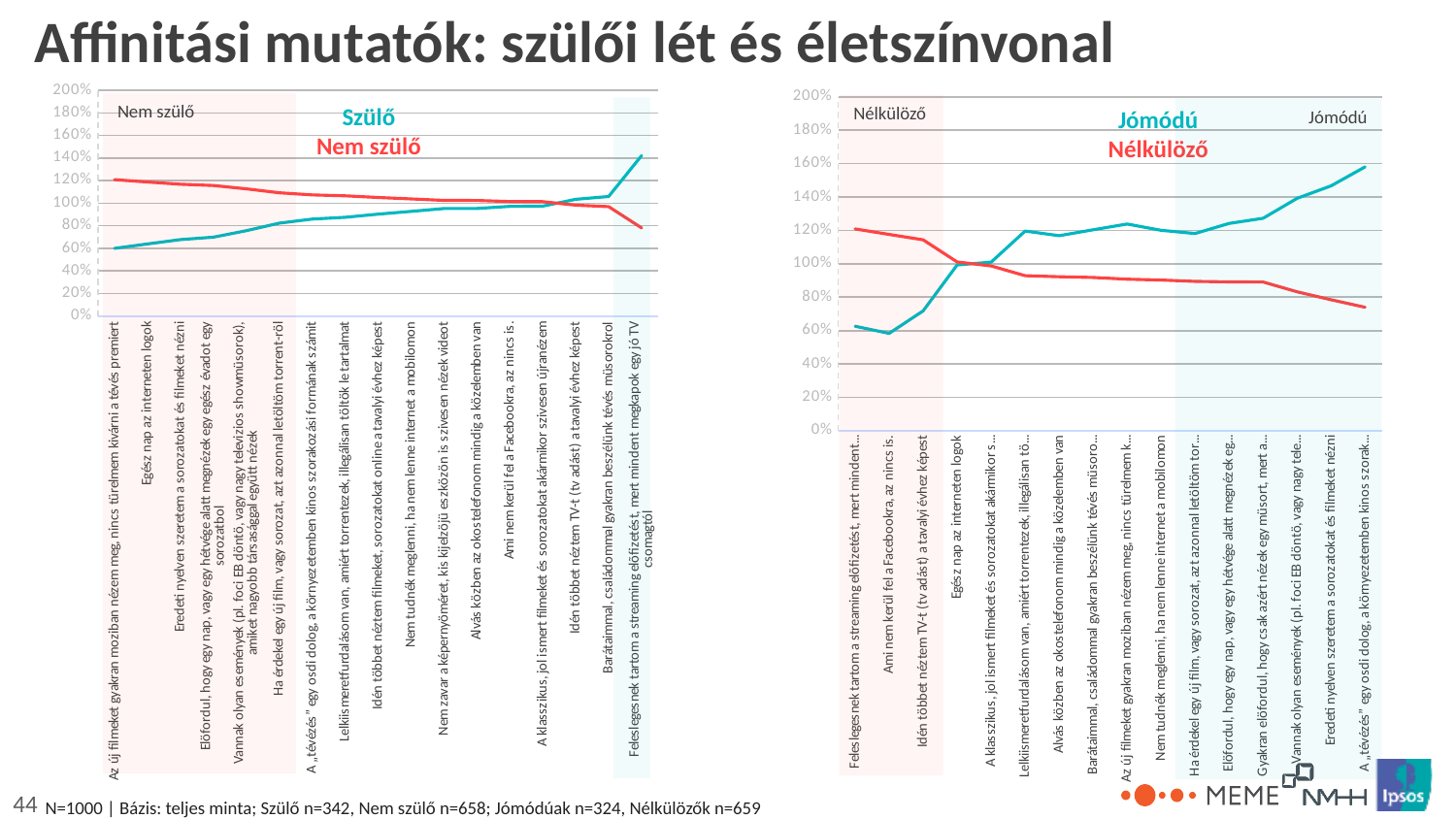
On the left chart, is the Szülő value for 'Feleslegesnek tartom a streaming előfizetést, mert mindent megkapok egy jó TV csomagtól' greater or less than 120%? greater On the right chart, is the Nélkülöző value for 'Feleslegesnek tartom a streaming előfizetést, mert mindent...' greater or less than 100%? greater On the left chart, is the Nem szülő value for 'Az új filmeket gyakran moziban nézem meg, nincs türelmem kivárni a tévés premiert' greater or less than 100%? greater On the right chart, for 'A „tévézés" egy osdi dolog, a környezetemben kinos szorak...', which series has the larger value: Jómódú or Nélkülöző? Jómódú On the left chart, does the Szülő line generally rise or fall from left to right along the x axis? Rise On the left chart, for 'Egész nap az interneten logok', which series has the larger value: Szülő or Nem szülő? Nem szülő What is the title of the slide containing the two charts? Affinitási mutatók: szülői lét és életszínvonal What kind of chart is the left chart (Szülő / Nem szülő)? Line chart How many series does the right chart (Jómódú / Nélkülöző) plot? 2 On the right chart, does the Nélkülöző line generally rise or fall from left to right along the x axis? Fall